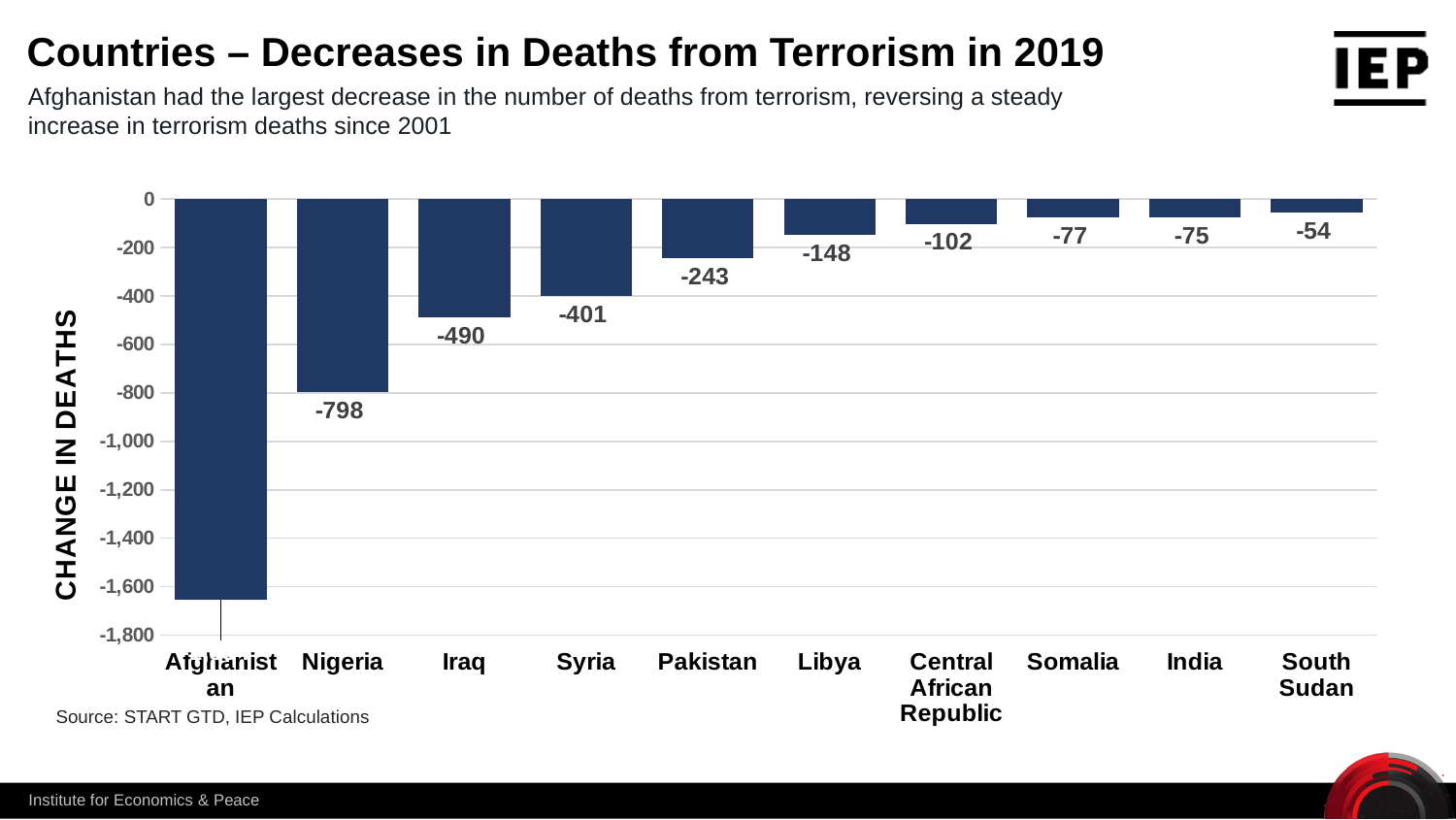
Which country shown had the smallest decrease in deaths from terrorism? South Sudan What is the change in deaths shown for the Central African Republic? -102 What is the change in deaths from terrorism shown for Nigeria? -798 What is the difference between the values for Syria and Pakistan? 158 How much larger is Nigeria's decrease in deaths than Iraq's? 308 Is the value for Afghanistan greater or less than -1,400? less Which country had the largest decrease in deaths from terrorism? Afghanistan What kind of chart is shown on the slide? Bar chart Which country had a larger decrease in deaths, Libya or Pakistan? Pakistan What value is shown for Iraq? -490 How many countries are shown in the chart? 10 What value is shown for South Sudan? -54